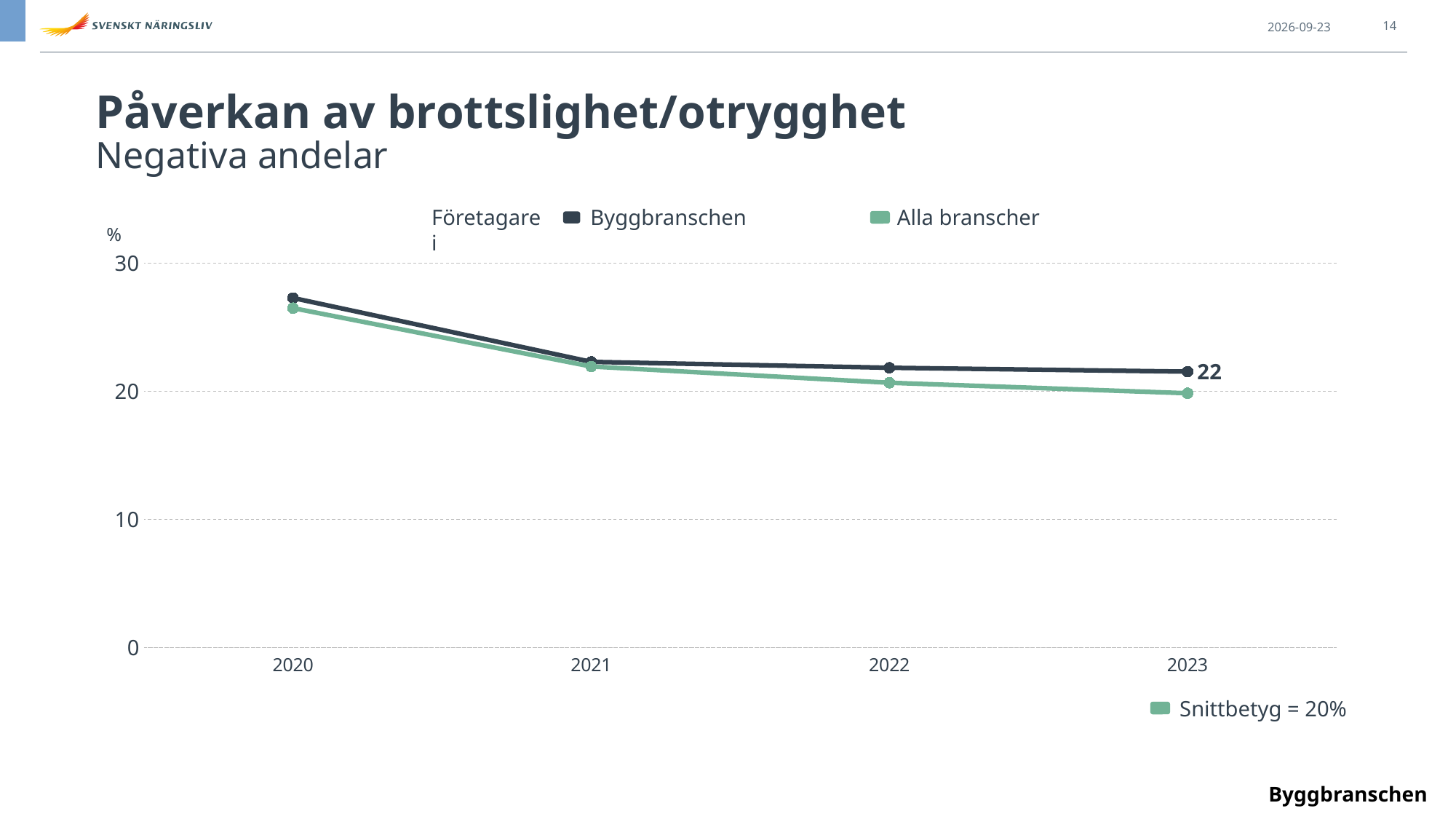
In 2023, which series has the larger value, Byggbranschen or Alla branscher? Byggbranschen What is the value for Byggbranschen in 2023? 22 How many series does the legend list? 2 Is the value for Alla branscher in 2021 greater or less than 30? less In which year is the value for Byggbranschen highest? 2020 What kind of chart is shown on the slide? line chart In which year is the value for Alla branscher lowest? 2023 How many years are plotted on the x axis? 4 Do the values for Byggbranschen rise or fall from 2020 to 2023? fall Is the value for Byggbranschen in 2020 greater or less than 20? greater What is the title of the chart on the slide? Påverkan av brottslighet/otrygghet Is the value for Alla branscher in 2022 greater or less than 10? greater